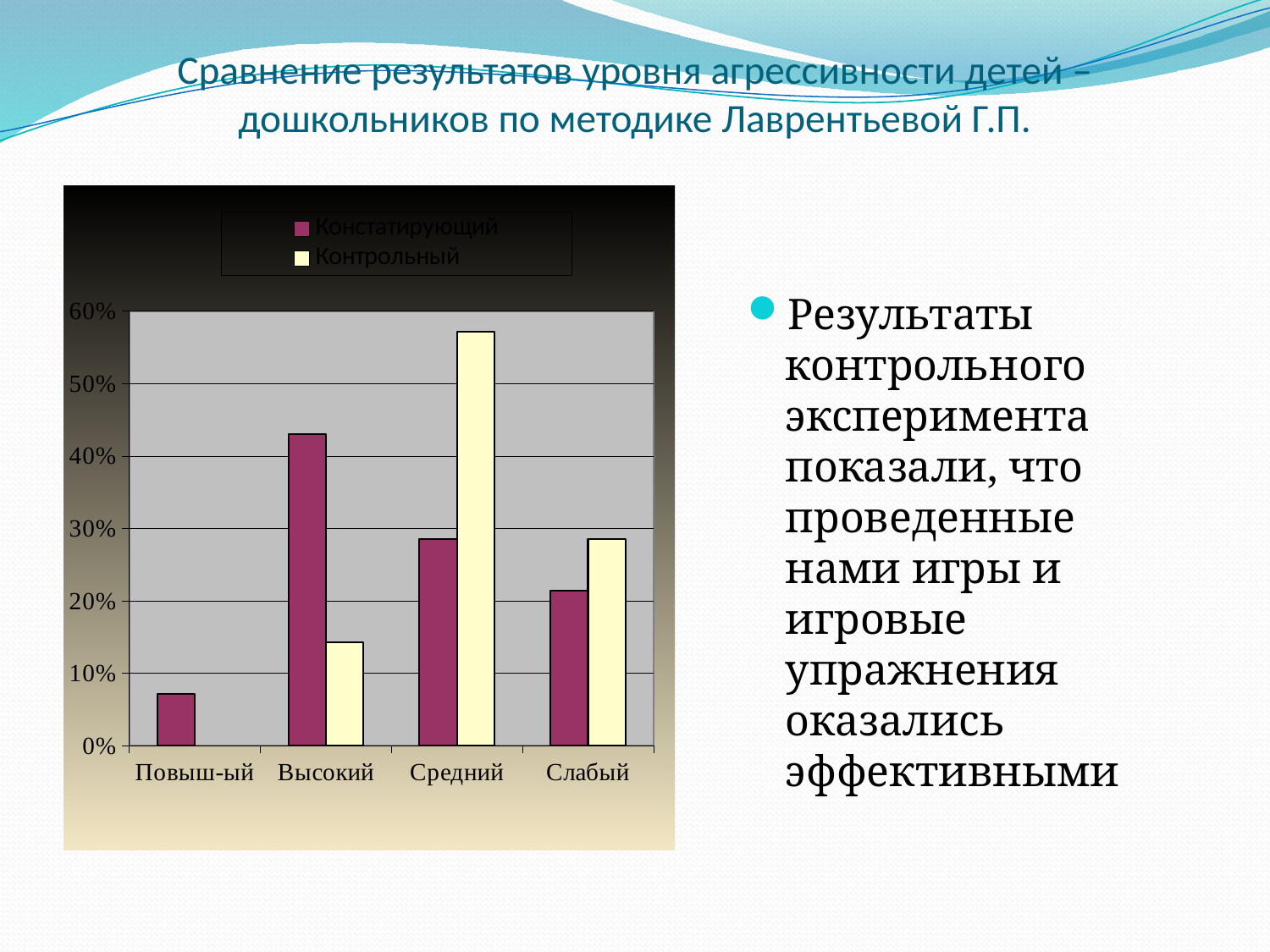
What kind of chart is shown on the slide? bar chart Which category has the lowest value for the Констатирующий series? Повыш-ый For the Средний category, which series has the larger value, Констатирующий or Контрольный? Контрольный Is the Констатирующий value for Повыш-ый greater or less than 10%? less Is the Контрольный value for Средний greater or less than 50%? greater How many series does the chart legend list? 2 What are the two series named in the chart legend? Констатирующий, Контрольный For the Высокий category, which series has the larger value, Констатирующий or Контрольный? Констатирующий Which category has the highest value for the Контрольный series? Средний How many categories are shown on the x axis of the chart? 4 Which category has the highest value for the Констатирующий series? Высокий Is the Констатирующий value for Высокий greater or less than 40%? greater